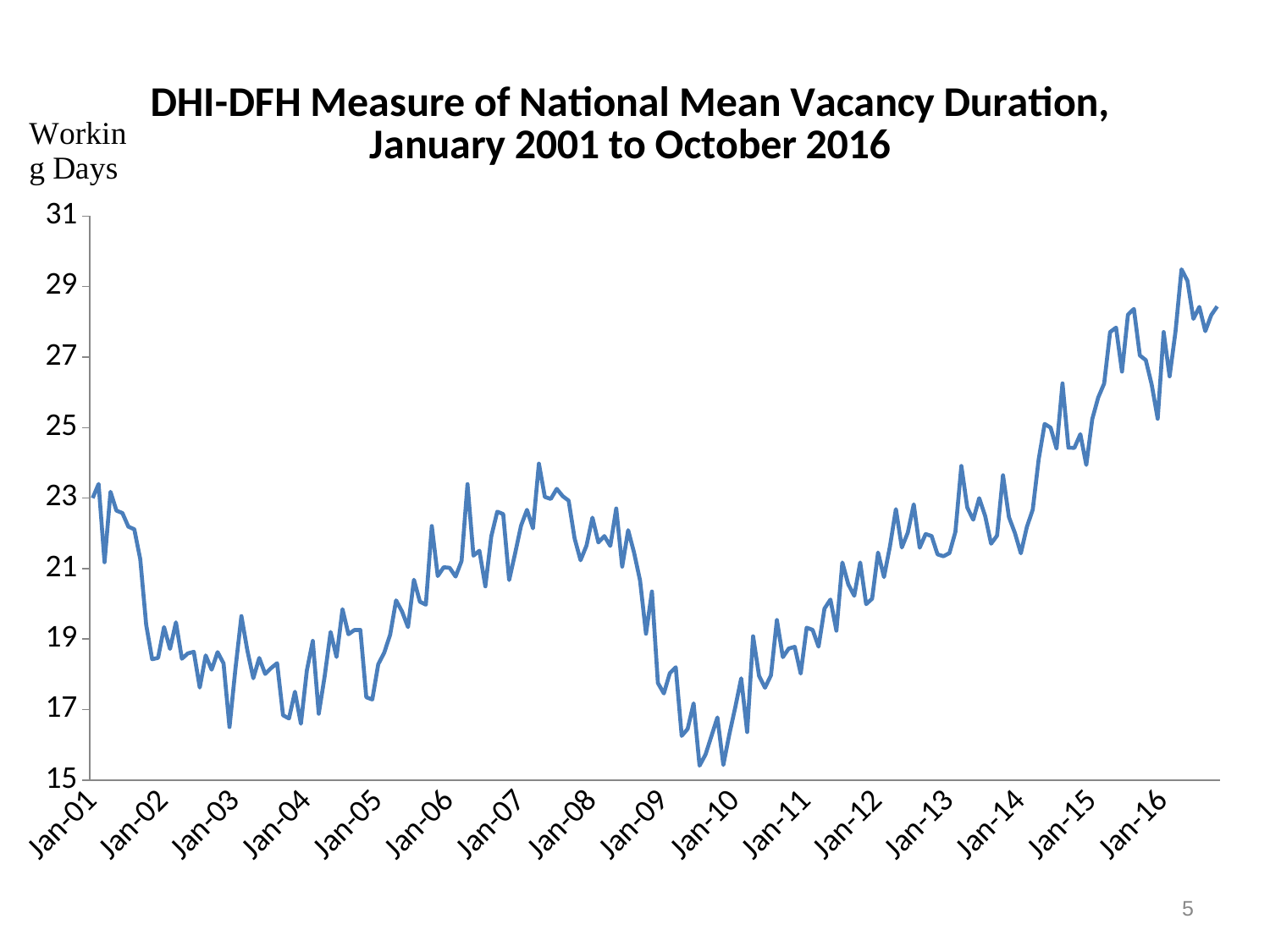
Is the value at Jan-01 greater or less than 21? greater Is the value at Jan-16 greater or less than 25? greater How many labelled tick marks are on the x axis? 16 Does the line rise or fall between Jan-10 and Jan-16? rise What is the title of the chart? DHI-DFH Measure of National Mean Vacancy Duration, January 2001 to October 2016 Is the value at Jan-03 greater or less than 21? less What unit is shown on the vertical axis label? Working Days What kind of chart is shown on the slide? line chart In which year does the line reach its highest value? 2016 How many data series are plotted on the chart? 1